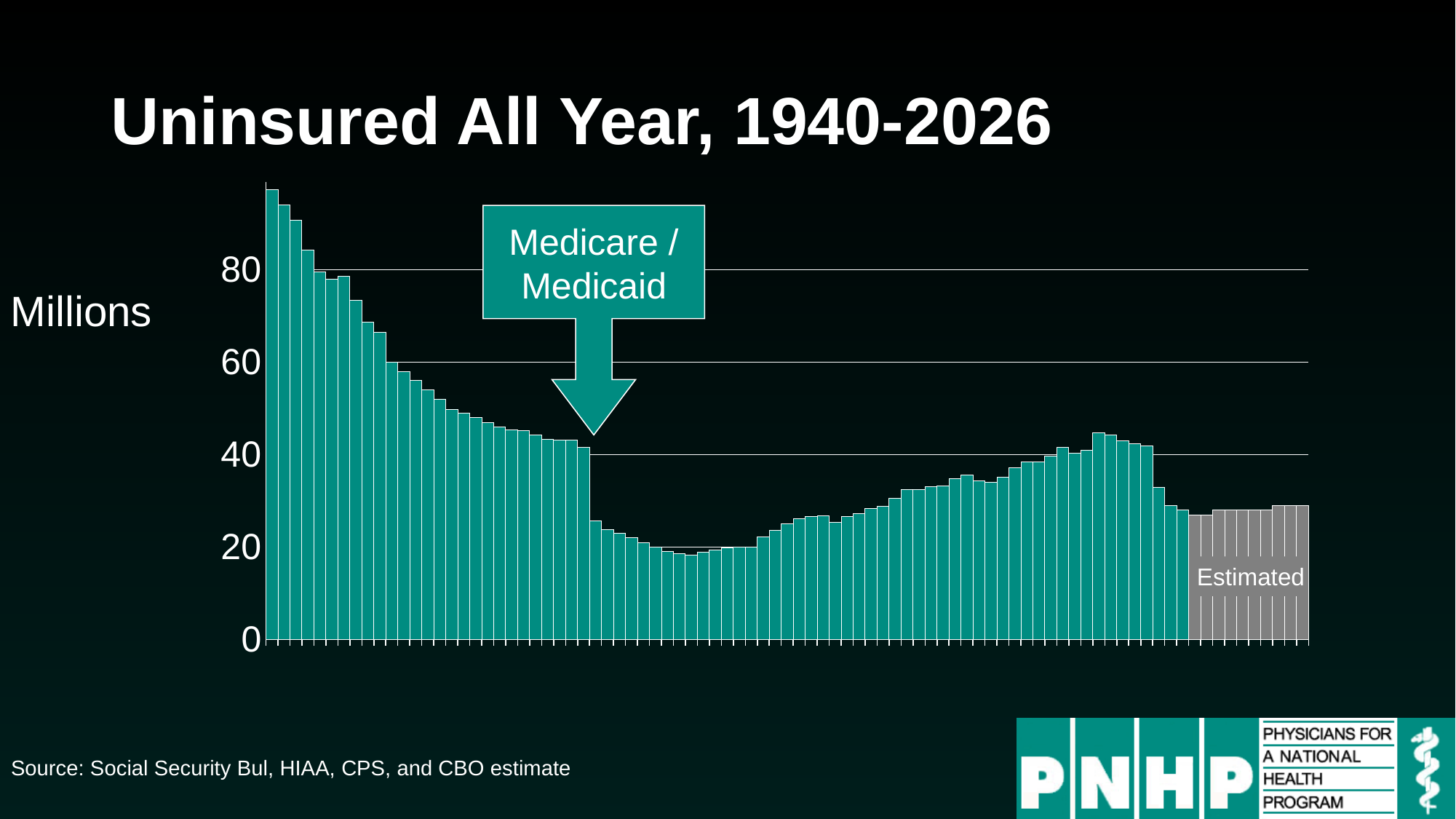
What kind of chart is shown on the slide? Bar chart Is the value of the first bar immediately after the Medicare / Medicaid arrow greater or less than 40? less Do the values rise or fall from the leftmost bar up to the point marked by the Medicare / Medicaid arrow? Fall What do the gray bars at the right end of the chart represent? Estimated Is the value of the rightmost (gray, estimated) bar greater or less than 40? less Which bar is the tallest in the chart? The leftmost (first) bar Is the value of the tallest teal bar to the right of the Medicare / Medicaid arrow greater or less than 60? less Which is larger, the leftmost bar or the rightmost bar? The leftmost bar What does the annotation with the arrow pointing at the chart say? Medicare / Medicaid